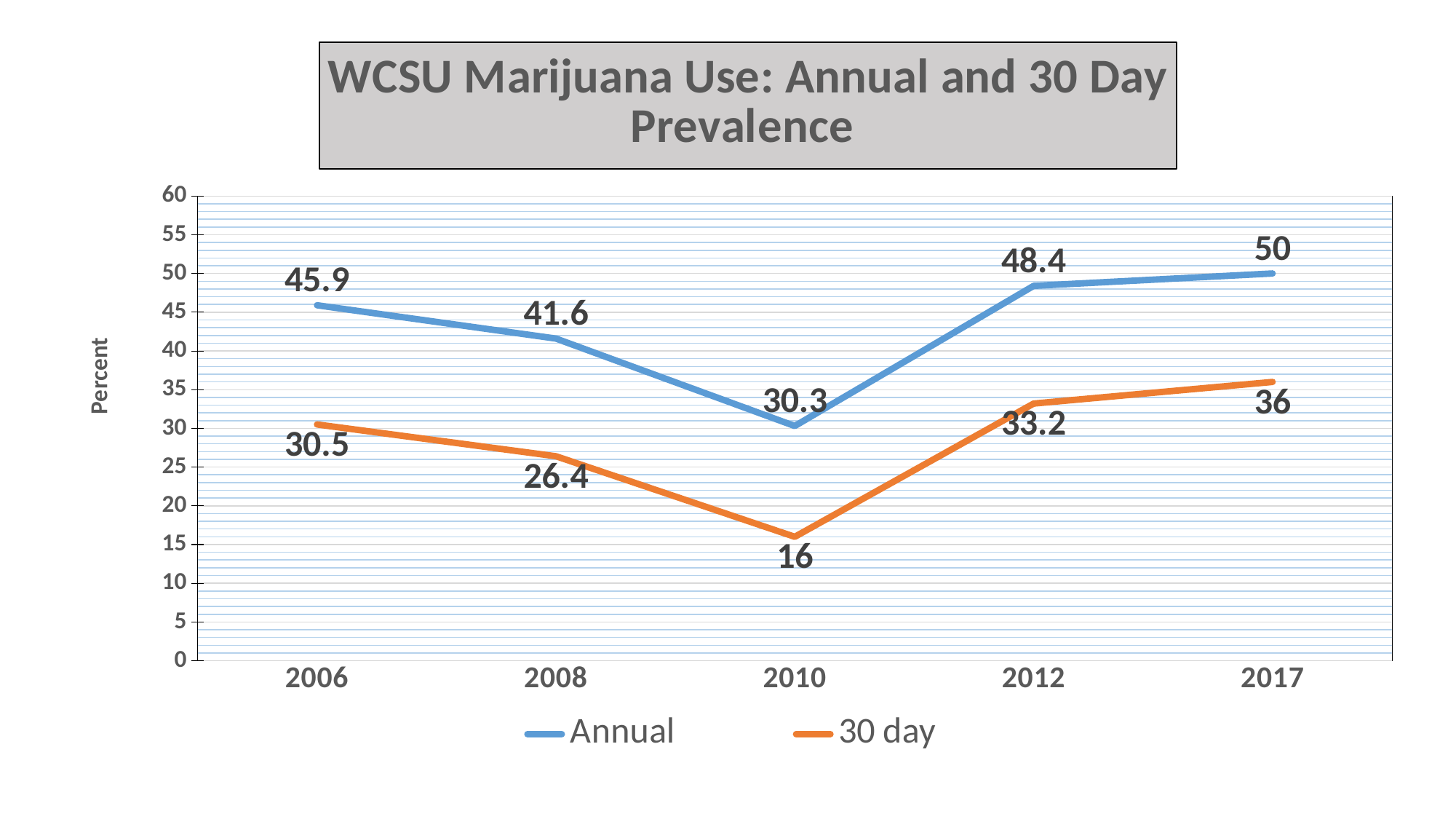
In which year is the 30 day value lowest? 2010 Which is larger, the Annual value for 2008 or the Annual value for 2012? 2012 How many years are shown on the x axis? 5 How many series does the legend list? 2 What kind of chart is shown? line chart What is the difference between the Annual and 30 day values in 2006? 15.4 What is the 30 day value for 2012? 33.2 What is the Annual value for 2017? 50 Does the 30 day value rise or fall from 2010 to 2017? rise In which year is the Annual value highest? 2017 What is the Annual value for 2010? 30.3 What is the label on the y axis? Percent